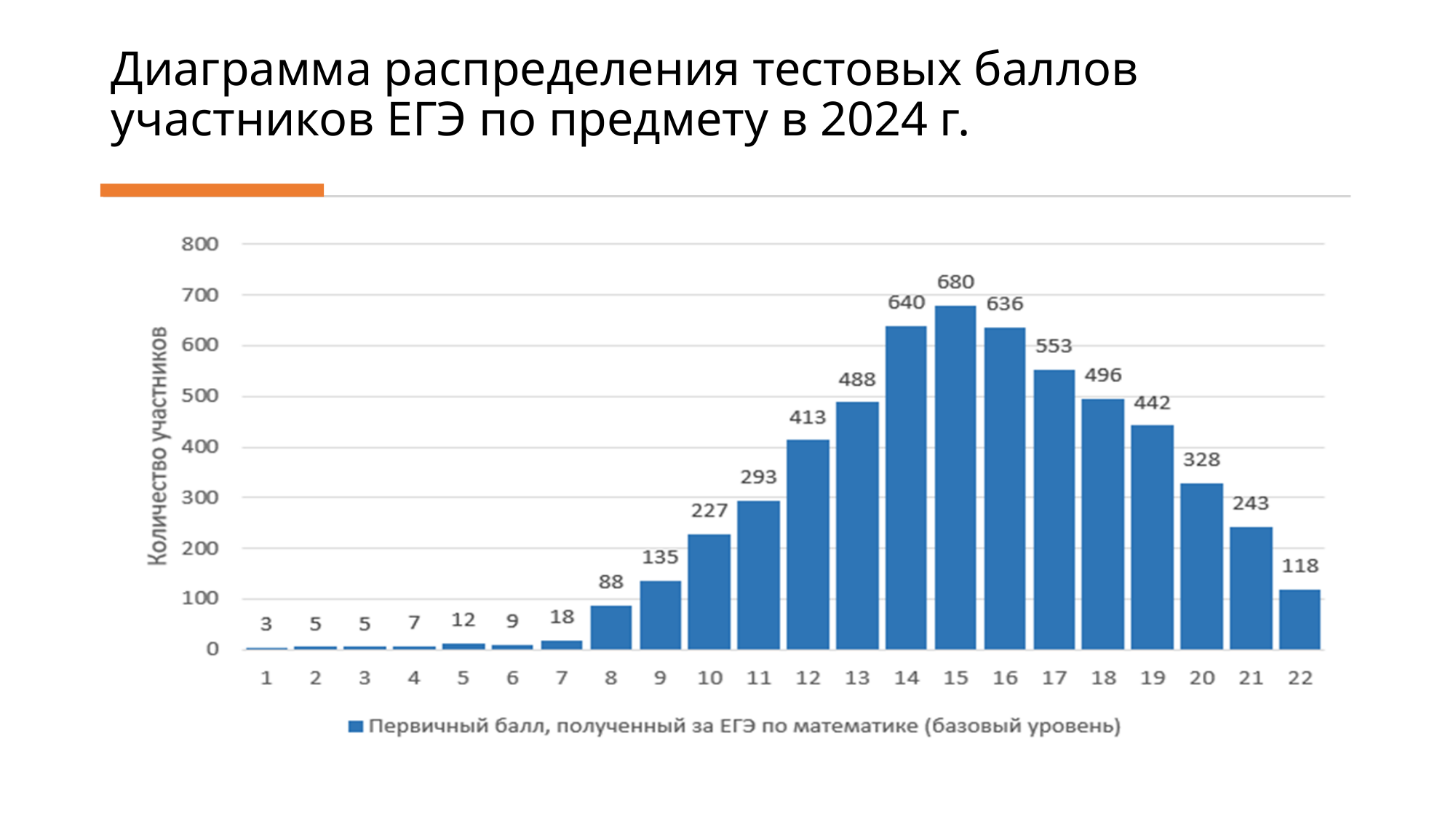
What is the label of the y axis? Количество участников How many series does the legend list? 1 What is the number of participants for a primary score of 9? 135 How many primary score categories are shown on the x axis? 22 Which primary score has the highest number of participants? 15 What kind of chart is shown on the slide? bar chart How many participants scored 15 primary points? 680 What is the difference between the number of participants with score 14 and score 16? 4 Do the values rise or fall from score 15 to score 22? fall Which has more participants: score 17 or score 18? 17 What is the difference between the number of participants with score 22 and score 21? 125 Which primary score has the lowest number of participants? 1